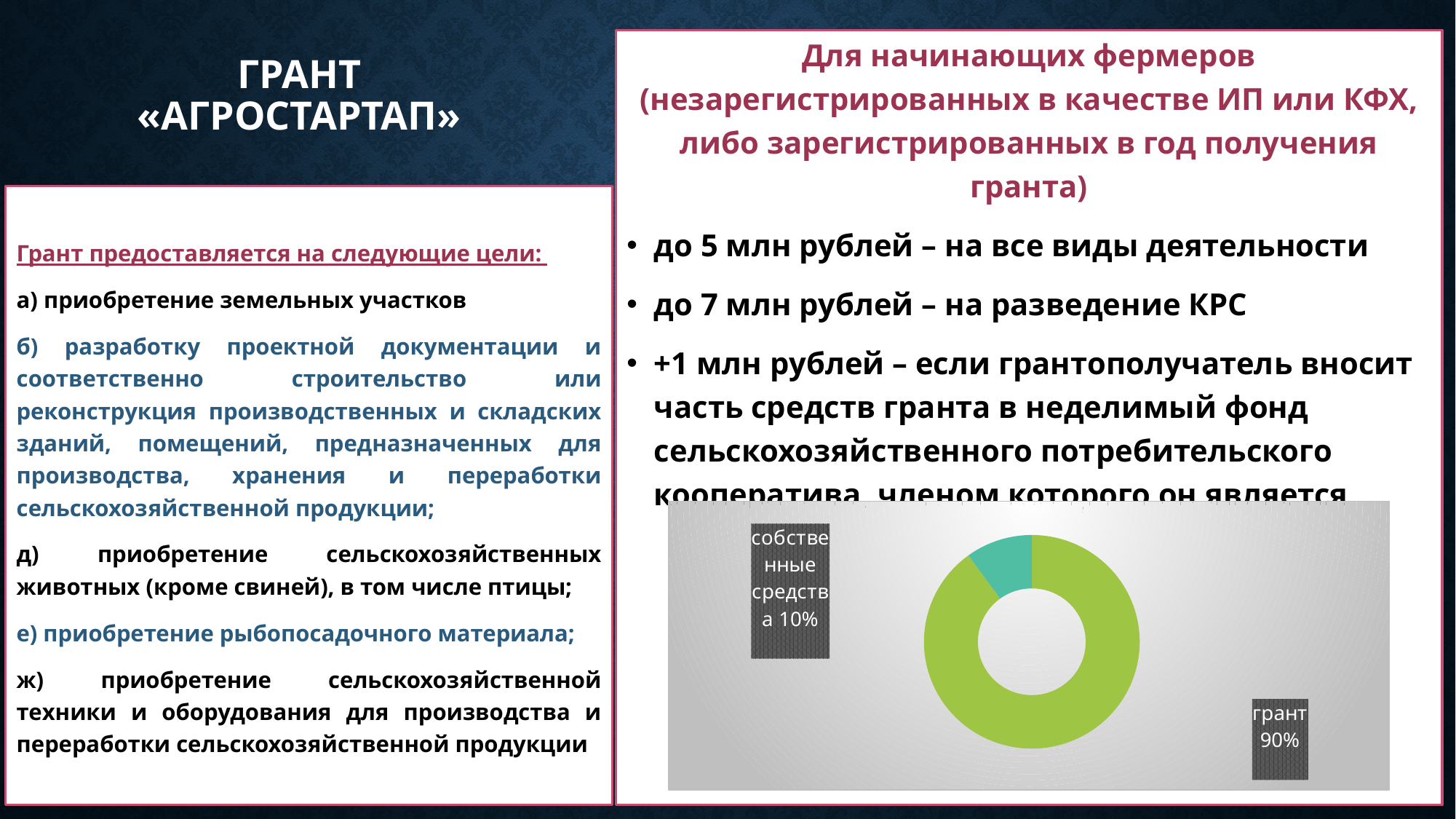
What share of the doughnut chart does "грант" represent? 90% What share of the doughnut chart does "собственные средства" represent? 10% Which is larger in the doughnut chart: "грант" or "собственные средства"? грант Which slice of the doughnut chart is the largest? грант What is the difference between the "грант" share and the "собственные средства" share in the doughnut chart? 80% What colour is the "грант" slice in the doughnut chart? green What colour is the "собственные средства" slice in the doughnut chart? teal What kind of chart is shown on the slide? doughnut chart How many slices does the doughnut chart have? 2 Which slice of the doughnut chart is the smallest? собственные средства